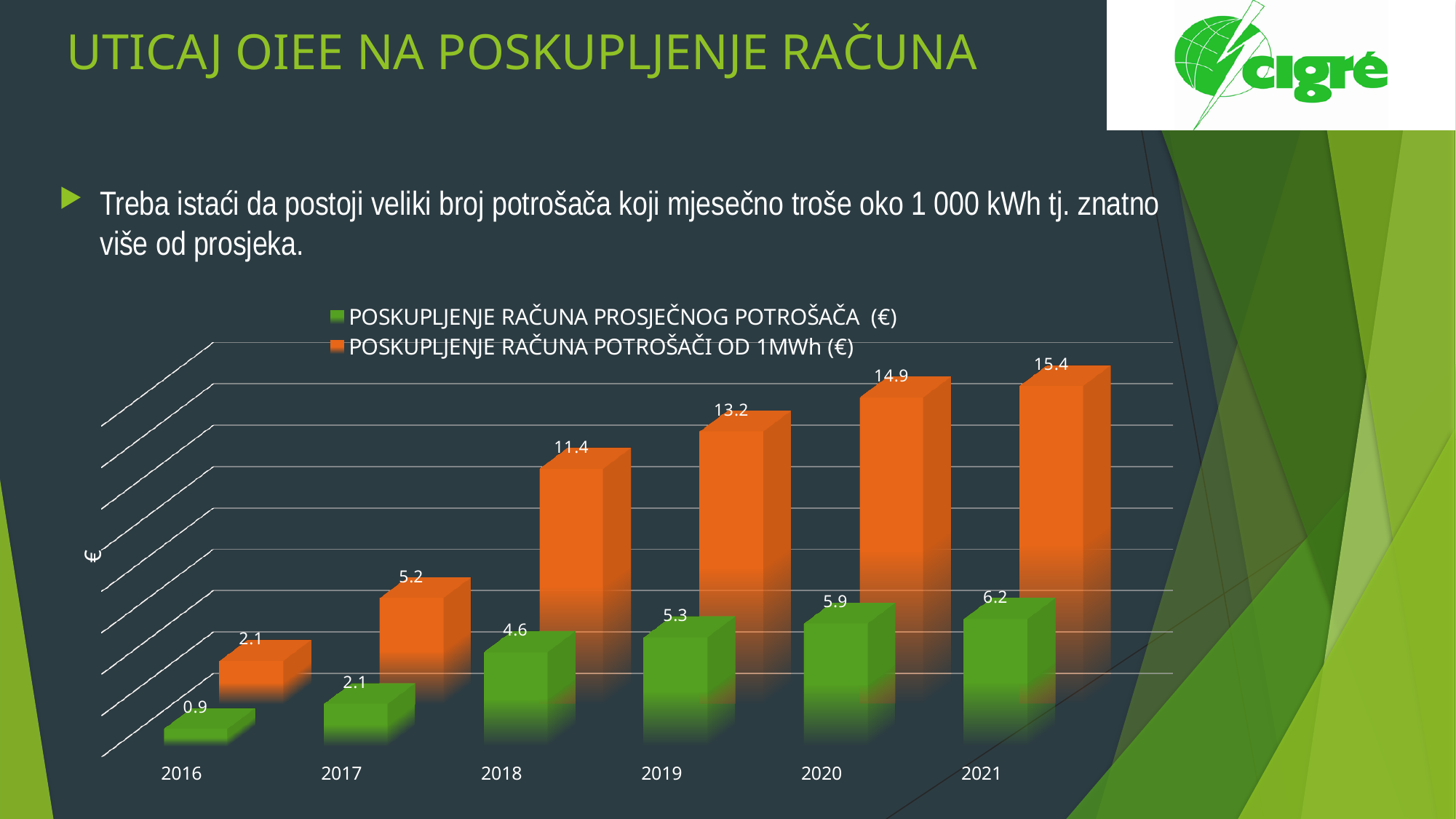
What is the value for 2016 in the series POSKUPLJENJE RAČUNA PROSJEČNOG POTROŠAČA (€)? 0.9 How many years are shown on the x axis of the chart? 6 How many series does the chart legend list? 2 What kind of chart is shown on the slide? Bar chart What is the difference between the two series' values for 2019? 7.9 What is the value for 2020 in the series POSKUPLJENJE RAČUNA PROSJEČNOG POTROŠAČA (€)? 5.9 Which year has the lowest value in the series POSKUPLJENJE RAČUNA PROSJEČNOG POTROŠAČA (€)? 2016 Do the values in the series POSKUPLJENJE RAČUNA POTROŠAČI OD 1MWh (€) rise or fall from 2016 to 2021? Rise What is the difference between the 2021 and 2016 values in the series POSKUPLJENJE RAČUNA POTROŠAČI OD 1MWh (€)? 13.3 What is the value for 2018 in the series POSKUPLJENJE RAČUNA POTROŠAČI OD 1MWh (€)? 11.4 Which is larger for 2017: the value for POSKUPLJENJE RAČUNA PROSJEČNOG POTROŠAČA (€) or for POSKUPLJENJE RAČUNA POTROŠAČI OD 1MWh (€)? POSKUPLJENJE RAČUNA POTROŠAČI OD 1MWh (€) Which year has the highest value in the series POSKUPLJENJE RAČUNA POTROŠAČI OD 1MWh (€)? 2021